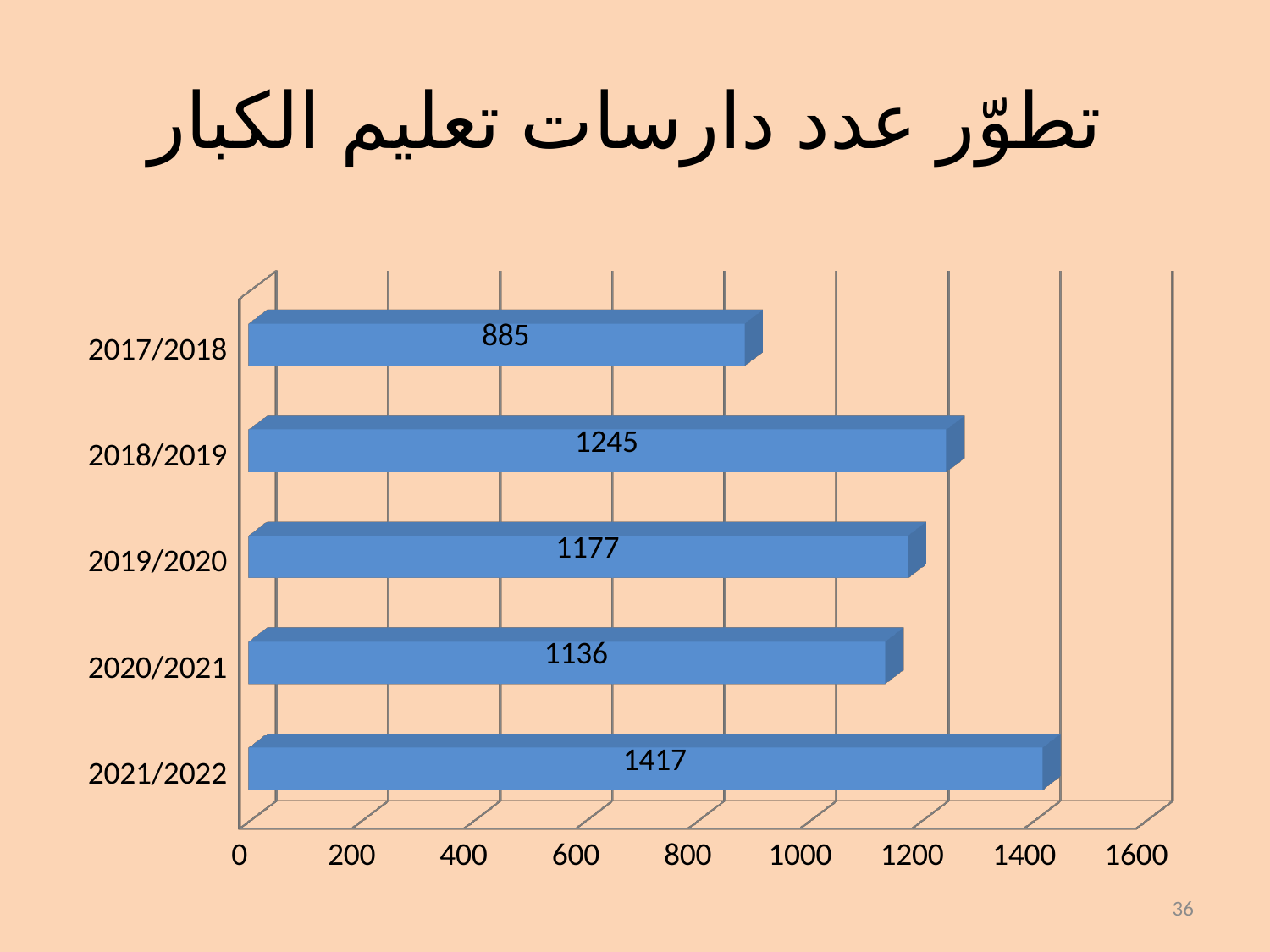
What is the difference between the values for 2021/2022 and 2017/2018? 532 Which year has the lowest value? 2017/2018 What is the value for 2019/2020? 1177 Which is larger, the value for 2018/2019 or the value for 2019/2020? 2018/2019 Is the value for 2020/2021 greater or less than 1000? greater What is the value for 2017/2018? 885 What is the difference between the values for 2018/2019 and 2020/2021? 109 What is the title of the chart? تطوّر عدد دارسات تعليم الكبار Which year has the highest value? 2021/2022 How many years are shown in the chart? 5 What is the value for 2021/2022? 1417 What kind of chart is shown on the slide? bar chart